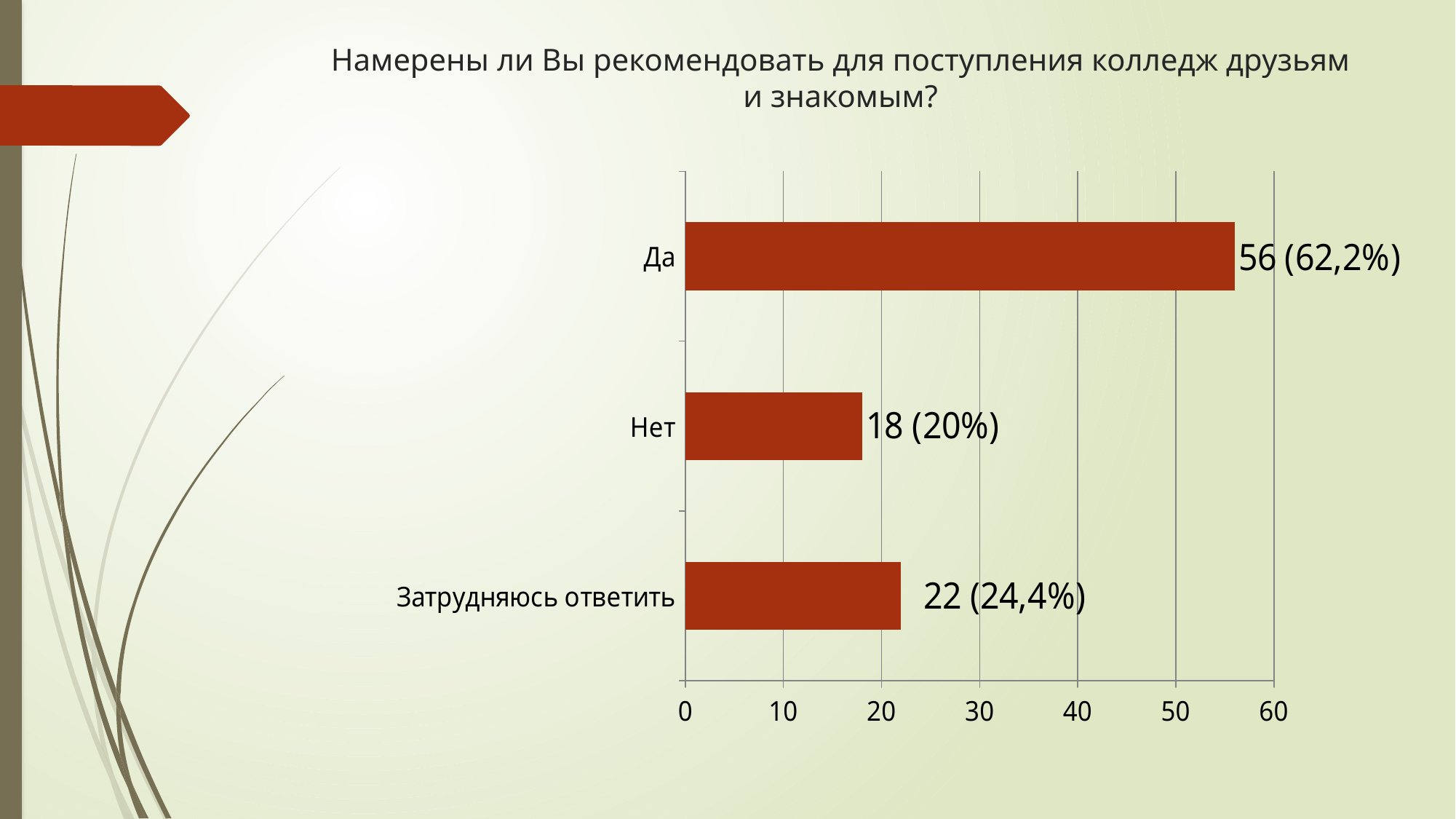
How many categories are shown in the chart? 3 What is the value for "Да"? 56 (62,2%) What kind of chart is shown on the slide? bar chart What is the value for "Затрудняюсь ответить"? 22 (24,4%) What is the value for "Нет"? 18 (20%) Which category has the highest value? Да Which is larger, the value for "Нет" or the value for "Затрудняюсь ответить"? Затрудняюсь ответить What is the title of the chart? Намерены ли Вы рекомендовать для поступления колледж друзьям и знакомым? Which category has the lowest value? Нет What is the difference between the counts for "Затрудняюсь ответить" and "Нет"? 4 What is the difference between the counts for "Да" and "Нет"? 38 Is the value for "Да" greater or less than 50? greater